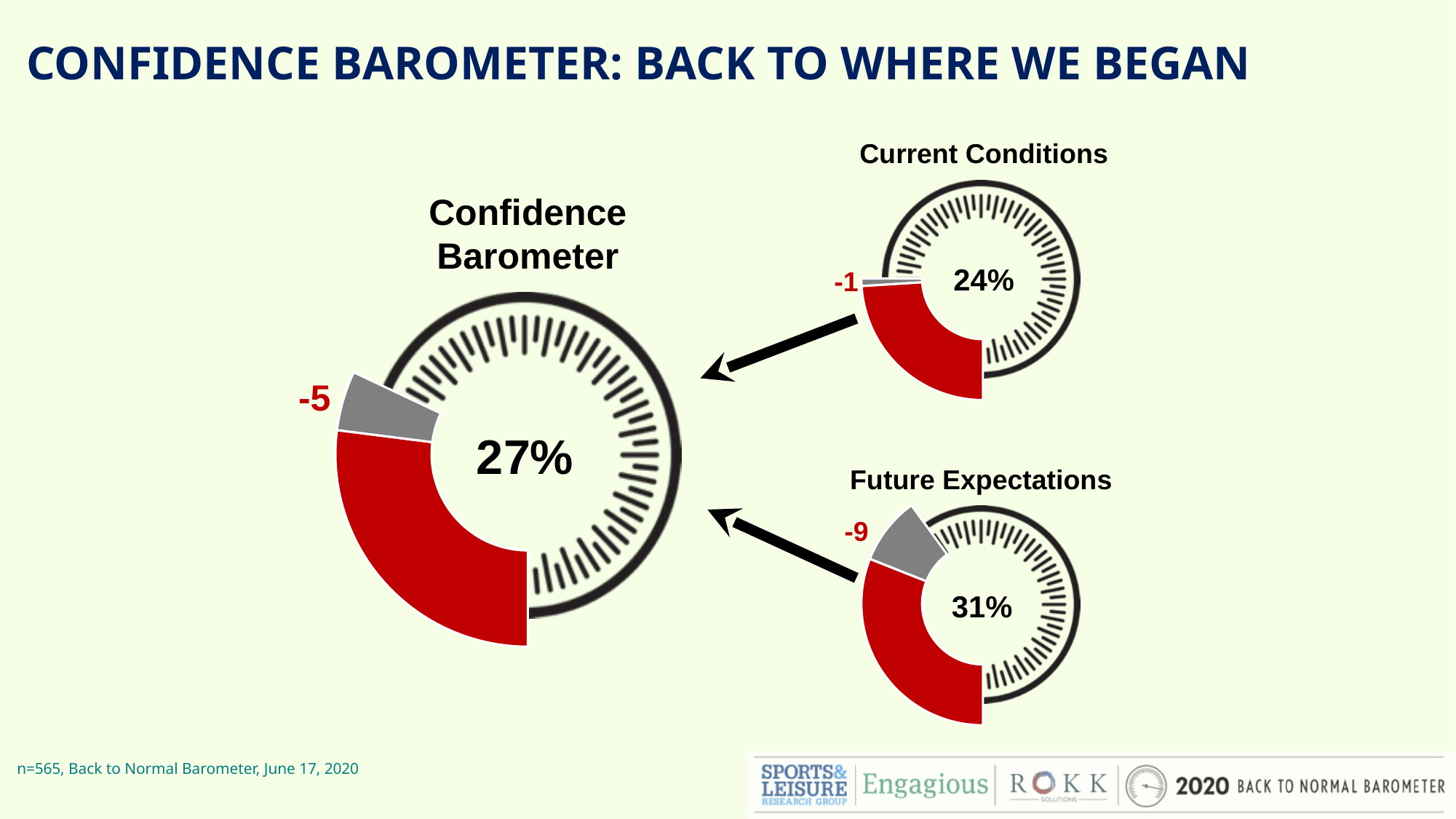
What is the difference between the Future Expectations value and the Current Conditions value? 7 percentage points Which of the three gauges shows the highest percentage? Future Expectations On the Future Expectations gauge, what value is shown in the centre? 31% On the Future Expectations gauge, what change is shown in red? -9 On the Current Conditions gauge, what change is shown in red? -1 Which is larger, the Confidence Barometer value or the Current Conditions value? Confidence Barometer On the Confidence Barometer gauge, what change is shown in red next to the grey segment? -5 How many gauge charts are shown on the slide? 3 On the Confidence Barometer gauge, what value is shown in the centre? 27% On the Current Conditions gauge, what value is shown in the centre? 24% Which gauge shows the largest decline? Future Expectations Which of the three gauges shows the lowest percentage? Current Conditions